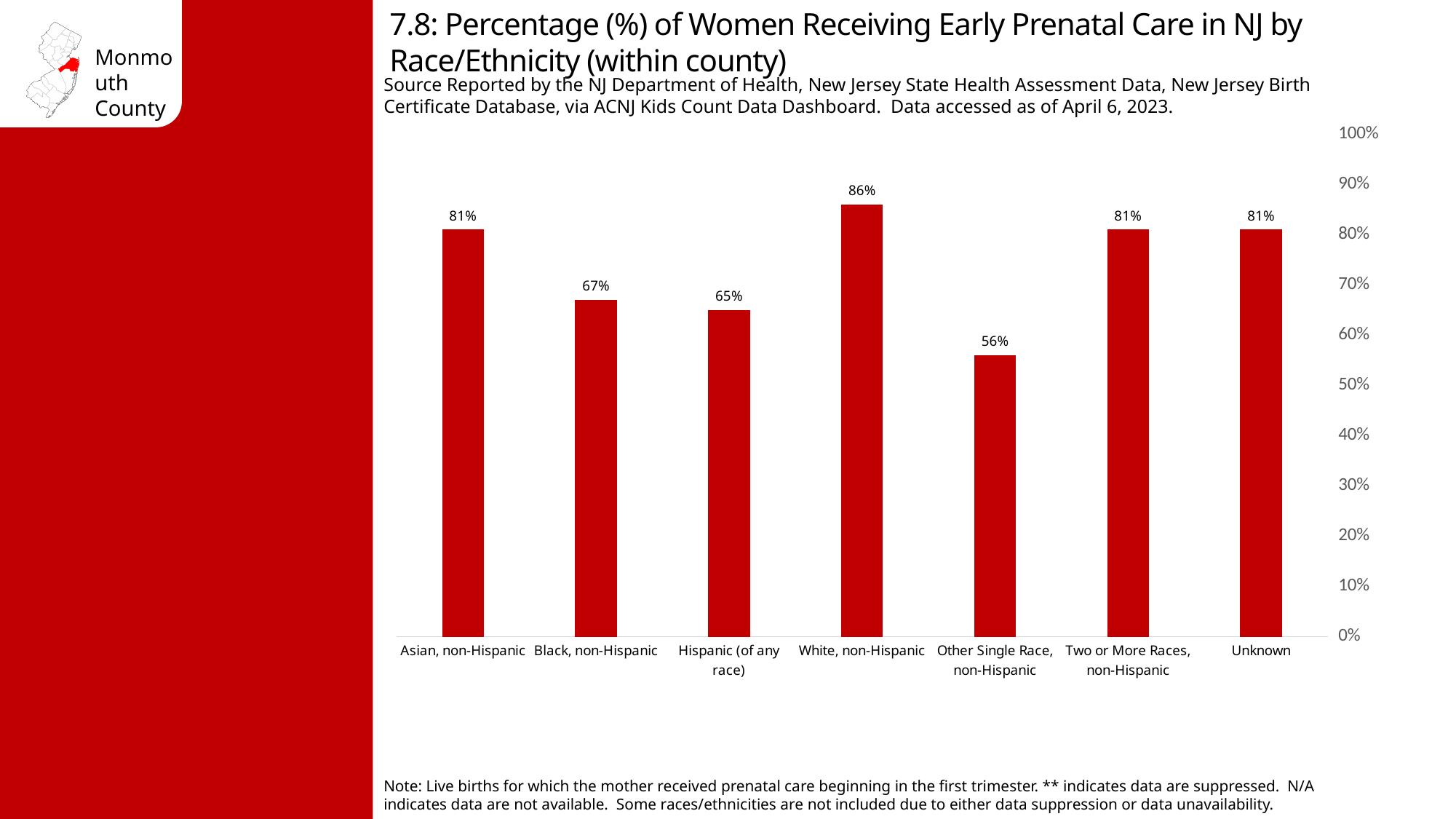
What is the value shown for Black, non-Hispanic? 67% What is the difference between the White, non-Hispanic value and the Other Single Race, non-Hispanic value? 30% What is the maximum value shown on the vertical axis? 100% Is the value for Unknown greater or less than 70%? greater What kind of chart is shown on the slide? Bar chart Which is larger, the value for Black, non-Hispanic or the value for Hispanic (of any race)? Black, non-Hispanic Which race/ethnicity category has the highest percentage of women receiving early prenatal care? White, non-Hispanic What is the value for Other Single Race, non-Hispanic? 56% What percentage is shown for Hispanic (of any race)? 65% Which category has the lowest percentage? Other Single Race, non-Hispanic What percentage of Asian, non-Hispanic women received early prenatal care? 81% How many race/ethnicity categories are shown on the chart? 7